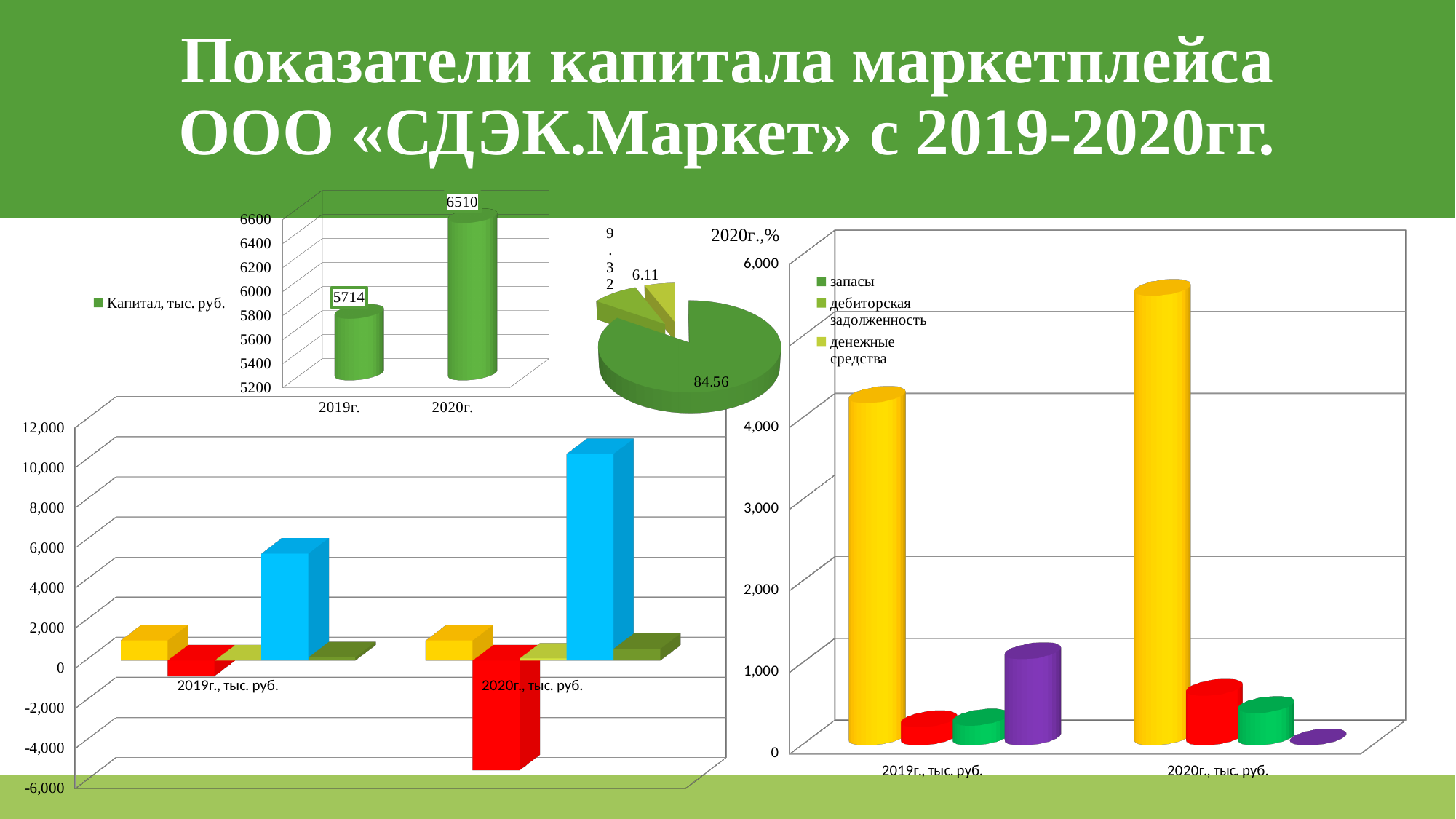
In the pie chart titled '2020г.,%', what share does 'запасы' have? 84.56 In the bottom-left chart, is the value of the red bar for '2020г., тыс. руб.' greater or less than -2,000? less In the bottom-left chart, is the value of the blue bar for '2019г., тыс. руб.' greater or less than 4,000? greater In the top-left chart titled 'Капитал, тыс. руб.', what is the difference between the 2020г. and 2019г. values? 796 In the pie chart titled '2020г.,%', which slice is the largest? запасы In the pie chart titled '2020г.,%', what share does 'денежные средства' have? 6.11 In the top-left chart titled 'Капитал, тыс. руб.', what is the value for 2020г.? 6510 In the top-left chart titled 'Капитал, тыс. руб.', do the values rise or fall from 2019г. to 2020г.? rise In the bottom-right chart, which yellow bar is larger: '2019г., тыс. руб.' or '2020г., тыс. руб.'? 2020г., тыс. руб. In the top-left chart titled 'Капитал, тыс. руб.', what is the value for 2019г.? 5714 In the bottom-right chart, is the value of the yellow bar for '2020г., тыс. руб.' greater or less than 5,000? greater In the pie chart titled '2020г.,%', how many slices are there? 3